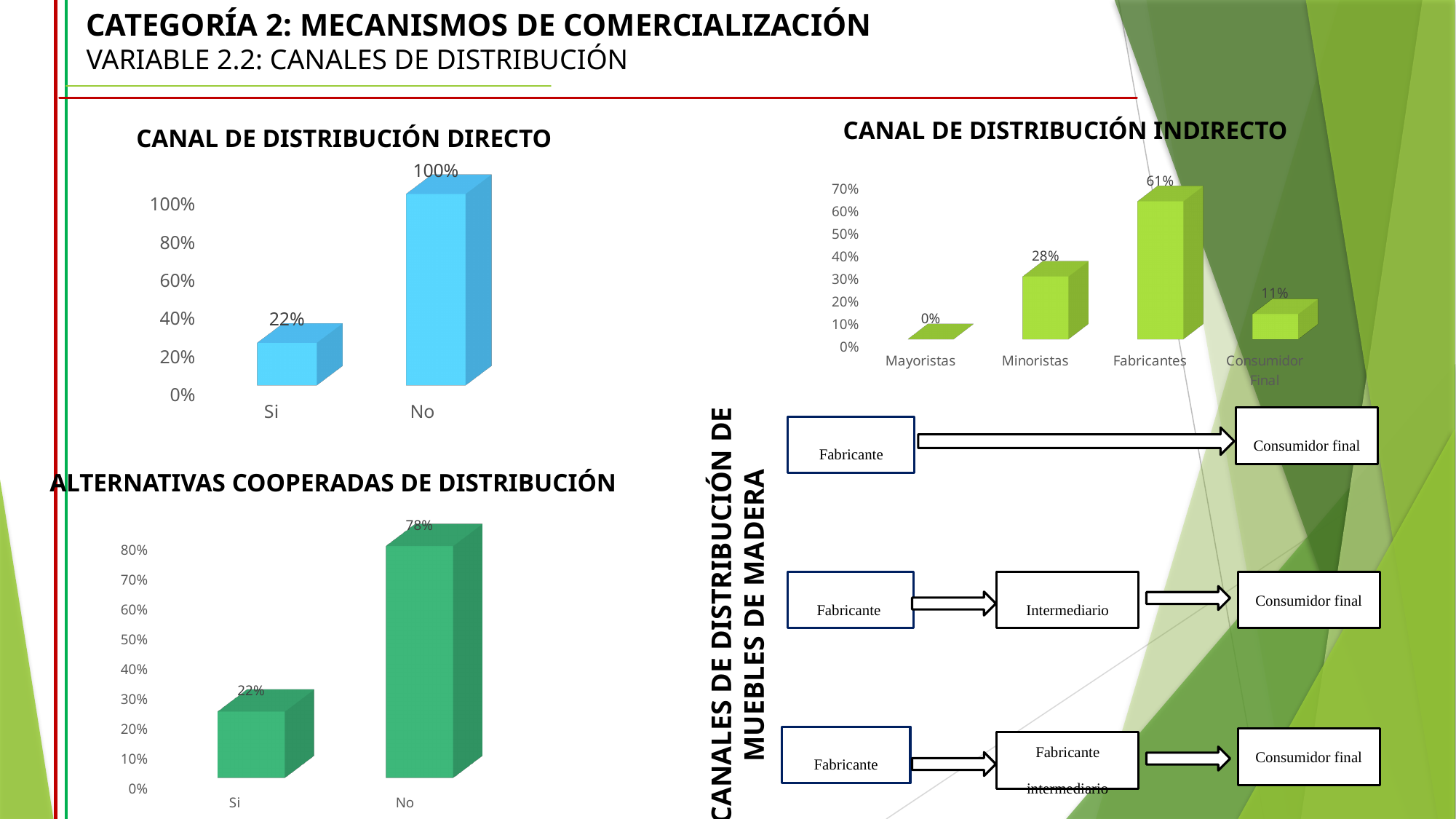
In the 'CANAL DE DISTRIBUCIÓN INDIRECTO' chart, how many categories are shown? 4 In the 'CANAL DE DISTRIBUCIÓN DIRECTO' chart, what is the value for 'Si'? 22% In the 'CANAL DE DISTRIBUCIÓN INDIRECTO' chart, what is the difference between the values for 'Fabricantes' and 'Minoristas'? 33% In the 'ALTERNATIVAS COOPERADAS DE DISTRIBUCIÓN' chart, what is the value for 'No'? 78% In the 'ALTERNATIVAS COOPERADAS DE DISTRIBUCIÓN' chart, which is larger, 'Si' or 'No'? No In the 'CANAL DE DISTRIBUCIÓN INDIRECTO' chart, which category has the highest value? Fabricantes In the 'CANAL DE DISTRIBUCIÓN INDIRECTO' chart, what is the value for 'Consumidor Final'? 11% What kind of chart is 'ALTERNATIVAS COOPERADAS DE DISTRIBUCIÓN'? Bar chart In the 'CANAL DE DISTRIBUCIÓN INDIRECTO' chart, what is the value for 'Minoristas'? 28% In the 'CANAL DE DISTRIBUCIÓN DIRECTO' chart, what is the value for 'No'? 100% In the 'CANAL DE DISTRIBUCIÓN INDIRECTO' chart, which category has the lowest value? Mayoristas In the 'CANAL DE DISTRIBUCIÓN DIRECTO' chart, what is the difference between the values for 'No' and 'Si'? 78%